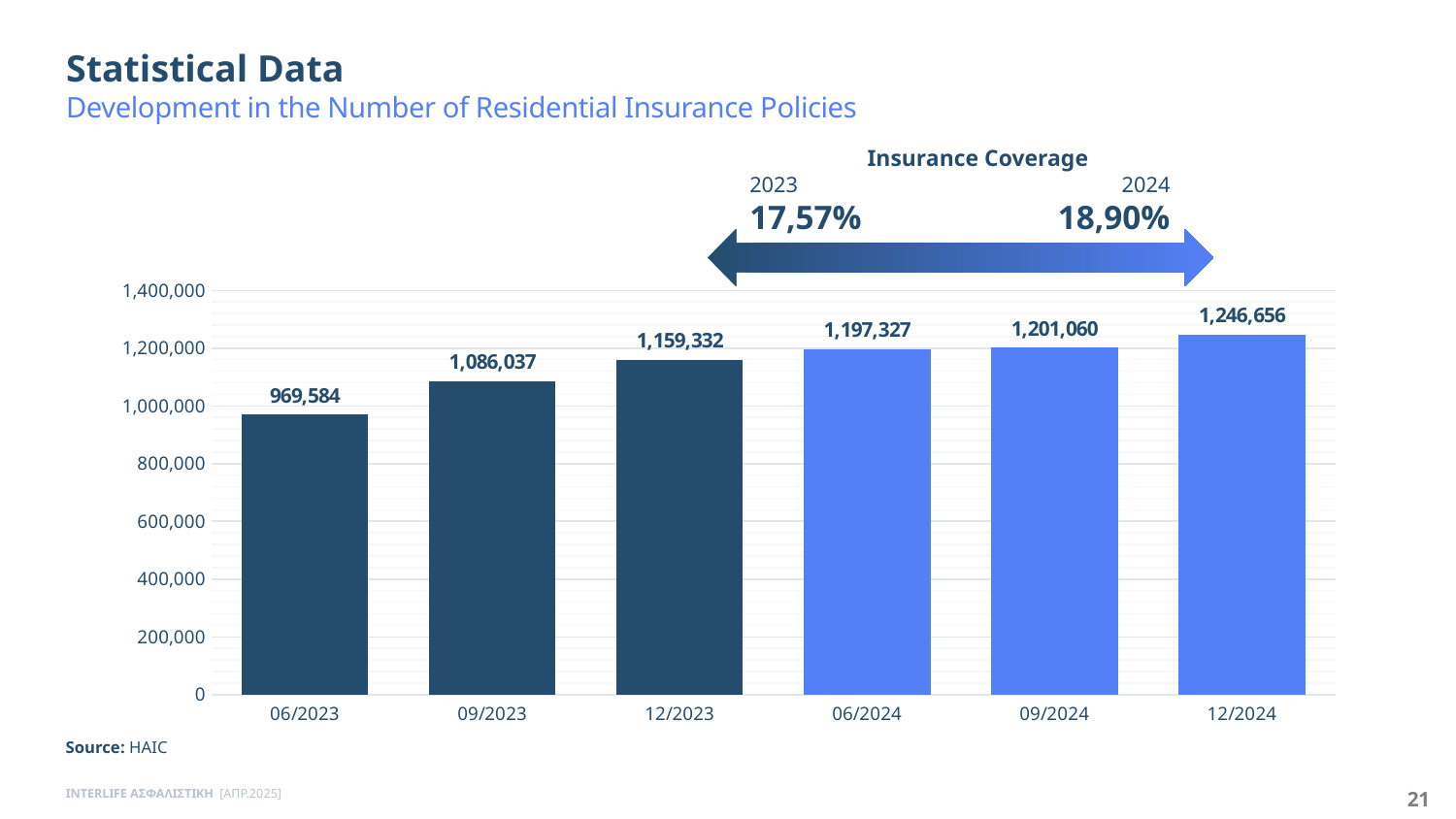
What is the difference between the values for 12/2024 and 06/2023? 277,072 Which period has the lowest number of residential insurance policies? 06/2023 What is the number of residential insurance policies for 06/2023? 969,584 What kind of chart is shown on the slide? bar chart How many periods are shown on the x axis of the chart? 6 What is the difference between the values for 12/2023 and 09/2023? 73,295 What is the number of residential insurance policies for 12/2024? 1,246,656 Which is larger, the value for 09/2023 or the value for 06/2024? 06/2024 What is the value shown for 09/2024? 1,201,060 Is the value for 12/2023 greater or less than 1,000,000? greater Do the values rise or fall from 06/2023 to 12/2024? rise Which period has the highest number of residential insurance policies? 12/2024